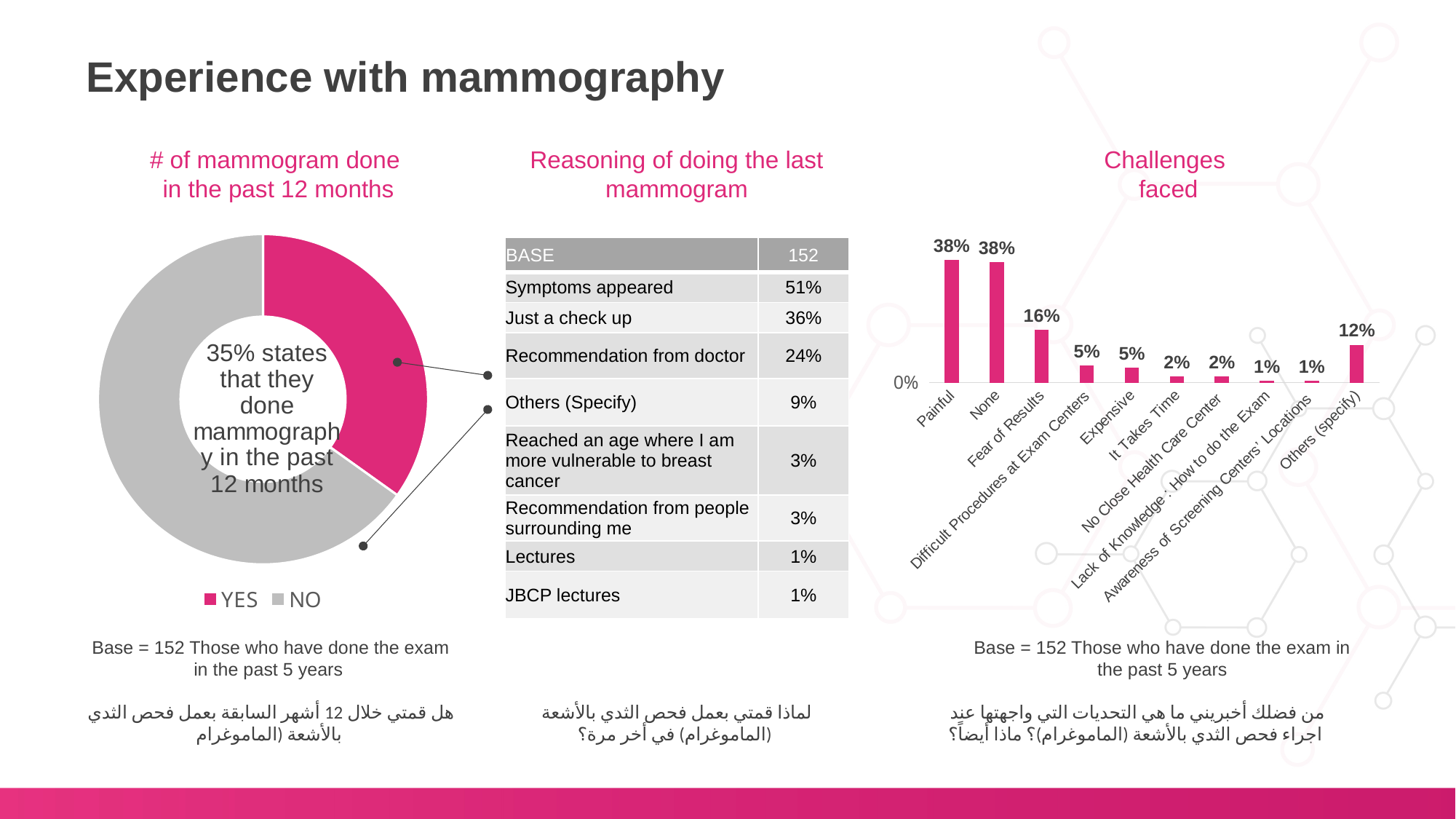
In the 'Challenges faced' chart, which is larger: Fear of Results or Others (specify)? Fear of Results In the 'Challenges faced' chart, what is the value for Painful? 38% What kind of chart is the 'Challenges faced' chart? Bar chart In the '# of mammogram done in the past 12 months' chart, what share of respondents answered YES? 35% In the 'Challenges faced' chart, what is the value for Others (specify)? 12% How many categories are shown in the 'Challenges faced' chart? 10 In the 'Challenges faced' chart, what is the value for Fear of Results? 16% In the '# of mammogram done in the past 12 months' chart, which colour represents NO? Grey In the 'Challenges faced' chart, what is the value for Expensive? 5% In the 'Challenges faced' chart, which is larger: It Takes Time or Difficult Procedures at Exam Centers? Difficult Procedures at Exam Centers In the 'Challenges faced' chart, what is the difference between Fear of Results and Others (specify)? 4% How many series does the legend of the '# of mammogram done in the past 12 months' chart list? 2